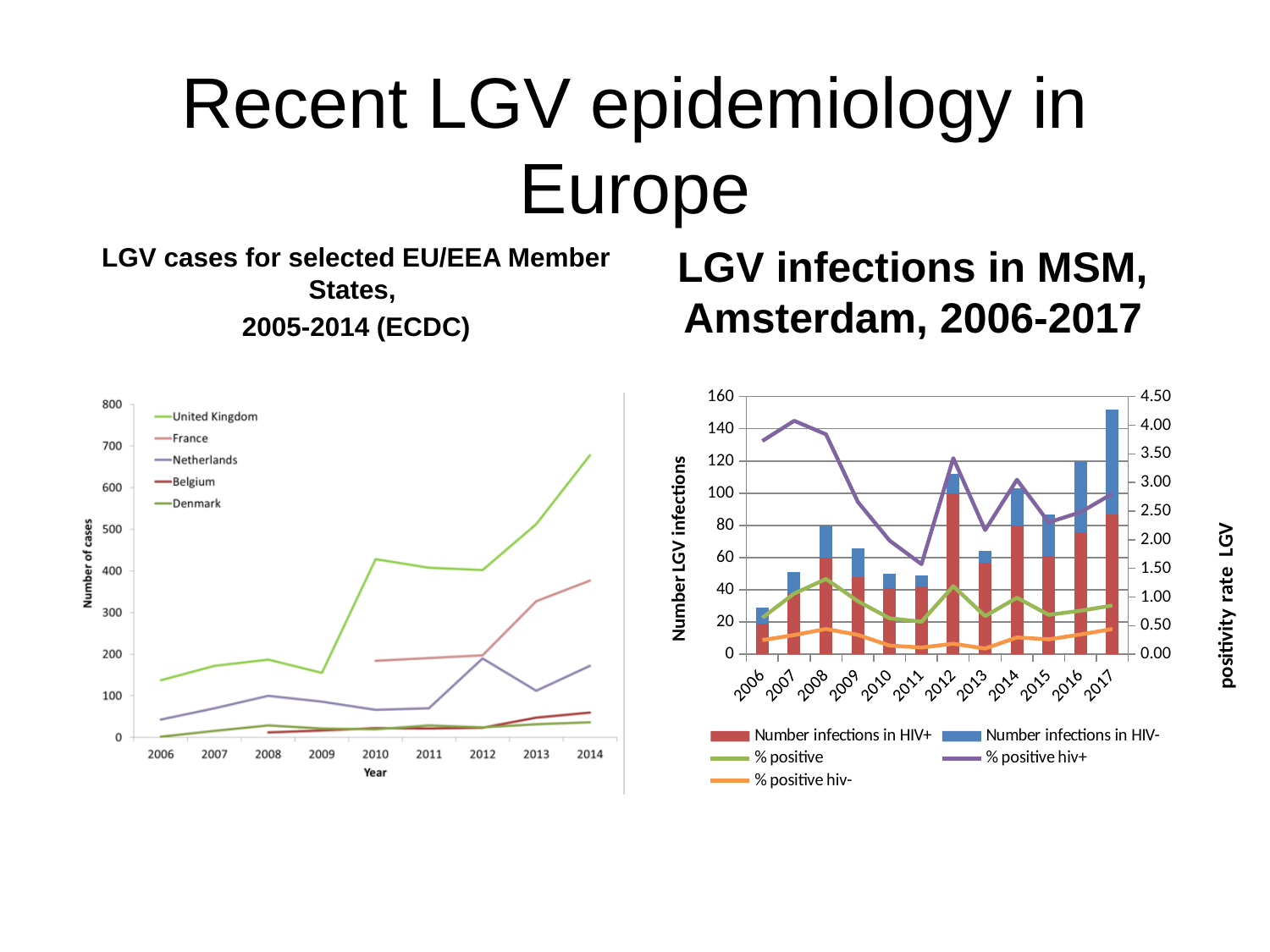
How many entries does the legend of the right chart, 'LGV infections in MSM, Amsterdam, 2006-2017', list? 5 What kind of chart is the left chart, 'LGV cases for selected EU/EEA Member States'? line chart In the right chart, which year has the tallest stacked bar of LGV infections? 2017 In the left chart, which is larger: the Netherlands value in 2012 or in 2013? 2012 In the left chart, is the number of cases for the United Kingdom in 2014 greater or less than 600? greater How many countries does the legend of the left chart list? 5 In the right chart, is the total number of LGV infections in 2017 greater or less than 140? greater How many years are shown on the x axis of the right chart? 12 How many years are shown on the x axis of the left chart? 9 In the left chart, is the number of cases for France in 2014 greater or less than 400? less In the left chart, do the United Kingdom cases rise or fall from 2012 to 2014? rise In the left chart, which country has the highest number of cases in 2014? United Kingdom